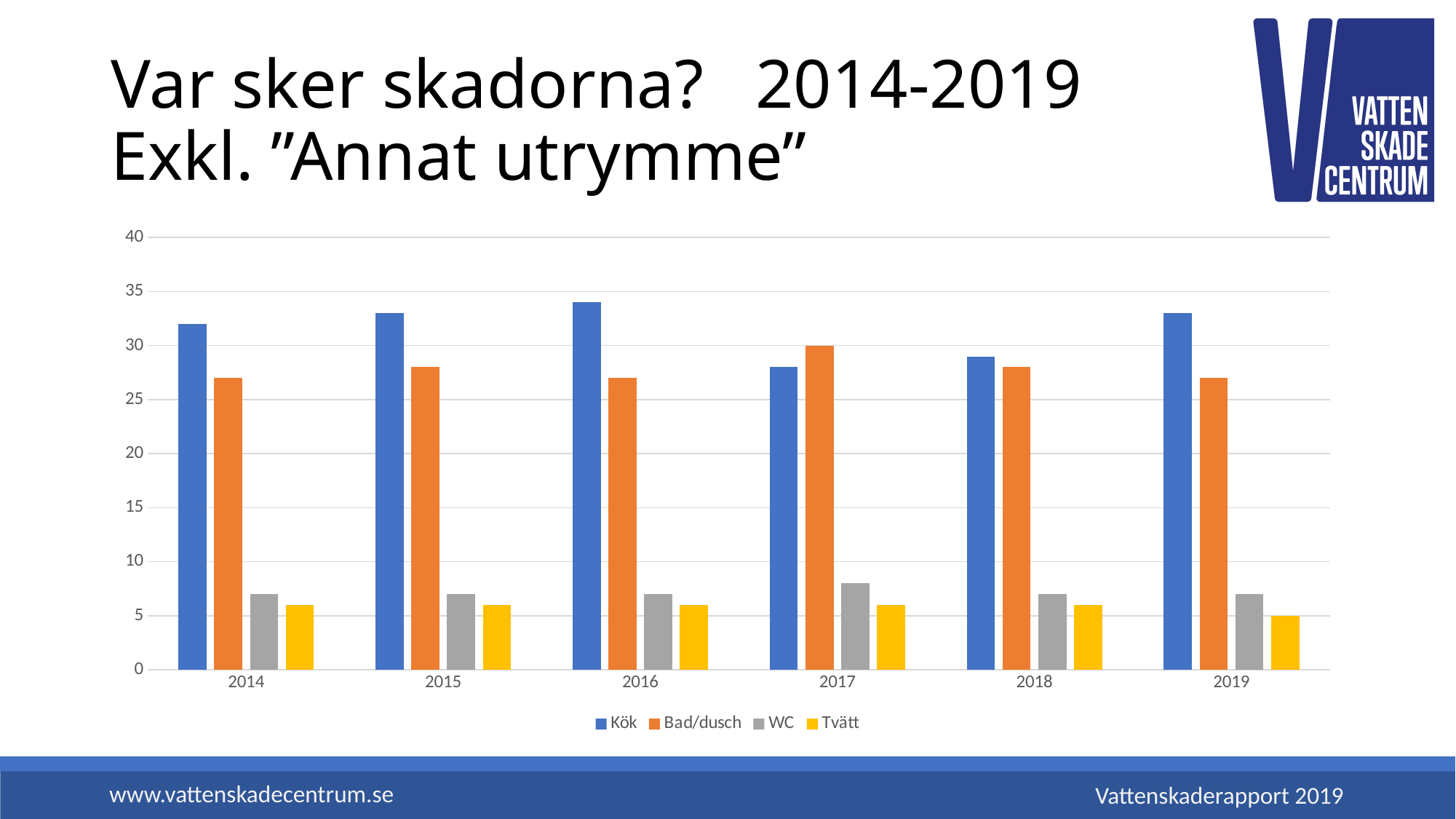
Is the value for Bad/dusch in 2017 greater or less than 25? greater How many series does the legend list? 4 How many years are shown on the x axis? 6 In 2017, which is larger: WC or Tvätt? WC Which series has the highest value in 2014? Kök Is the value for Kök in 2017 greater or less than 30? less What kind of chart is shown on the slide? bar chart Which series has the lowest value in 2019? Tvätt What colour represents Bad/dusch in the legend? orange In 2017, which is larger: Kök or Bad/dusch? Bad/dusch Is the value for WC in 2014 greater or less than 10? less